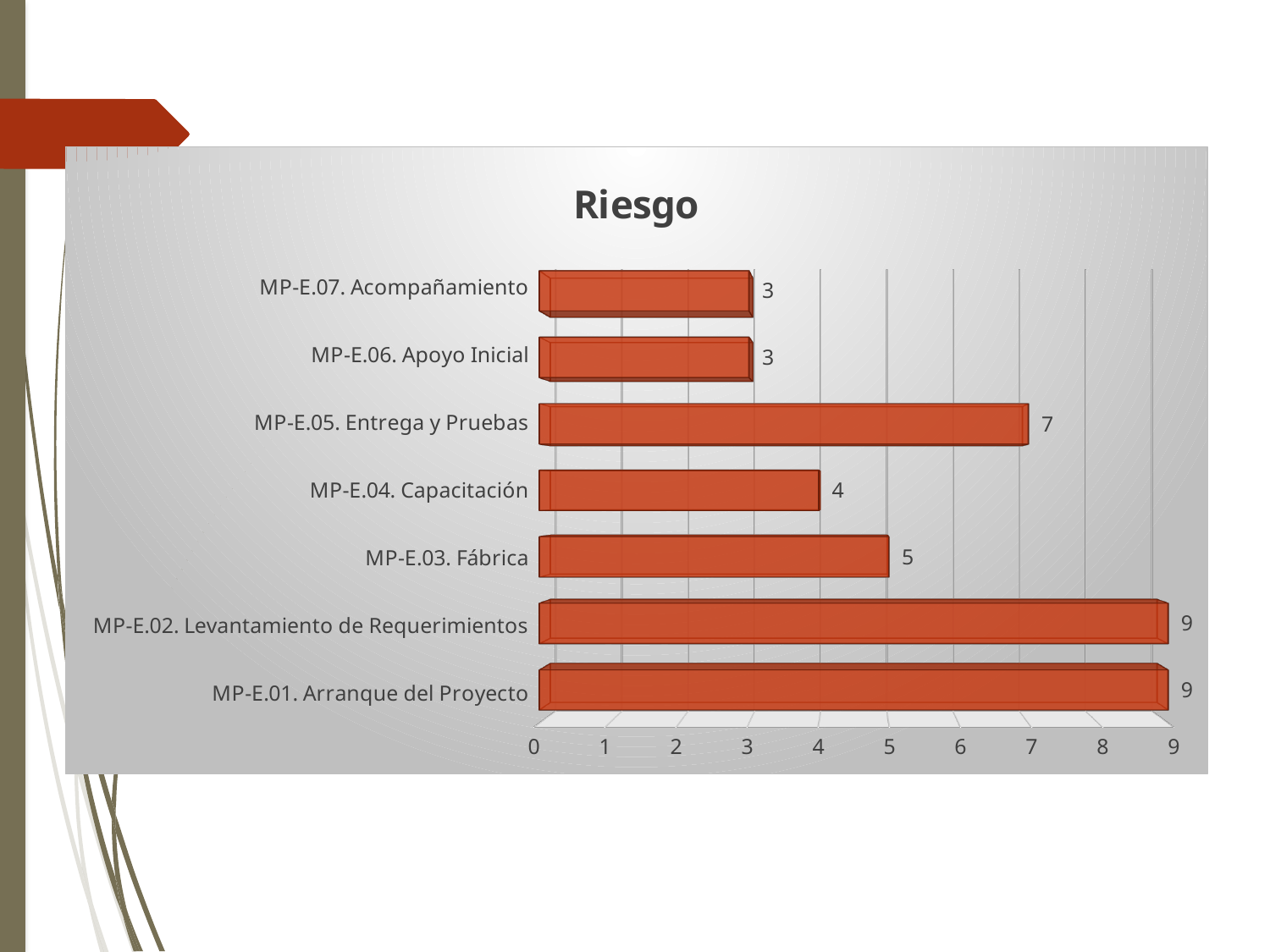
How many categories are shown in the chart? 7 What is the value for MP-E.05. Entrega y Pruebas? 7 What kind of chart is shown on the slide? Bar chart What is the value for MP-E.03. Fábrica? 5 What is the difference between the values for MP-E.02. Levantamiento de Requerimientos and MP-E.05. Entrega y Pruebas? 2 What is the value for MP-E.04. Capacitación? 4 Which categories have the lowest value? MP-E.06. Apoyo Inicial and MP-E.07. Acompañamiento What is the title of the chart? Riesgo What is the value for MP-E.07. Acompañamiento? 3 Which categories have the highest value? MP-E.01. Arranque del Proyecto and MP-E.02. Levantamiento de Requerimientos Which is larger, the value for MP-E.04. Capacitación or MP-E.05. Entrega y Pruebas? MP-E.05. Entrega y Pruebas What is the difference between the values for MP-E.03. Fábrica and MP-E.06. Apoyo Inicial? 2